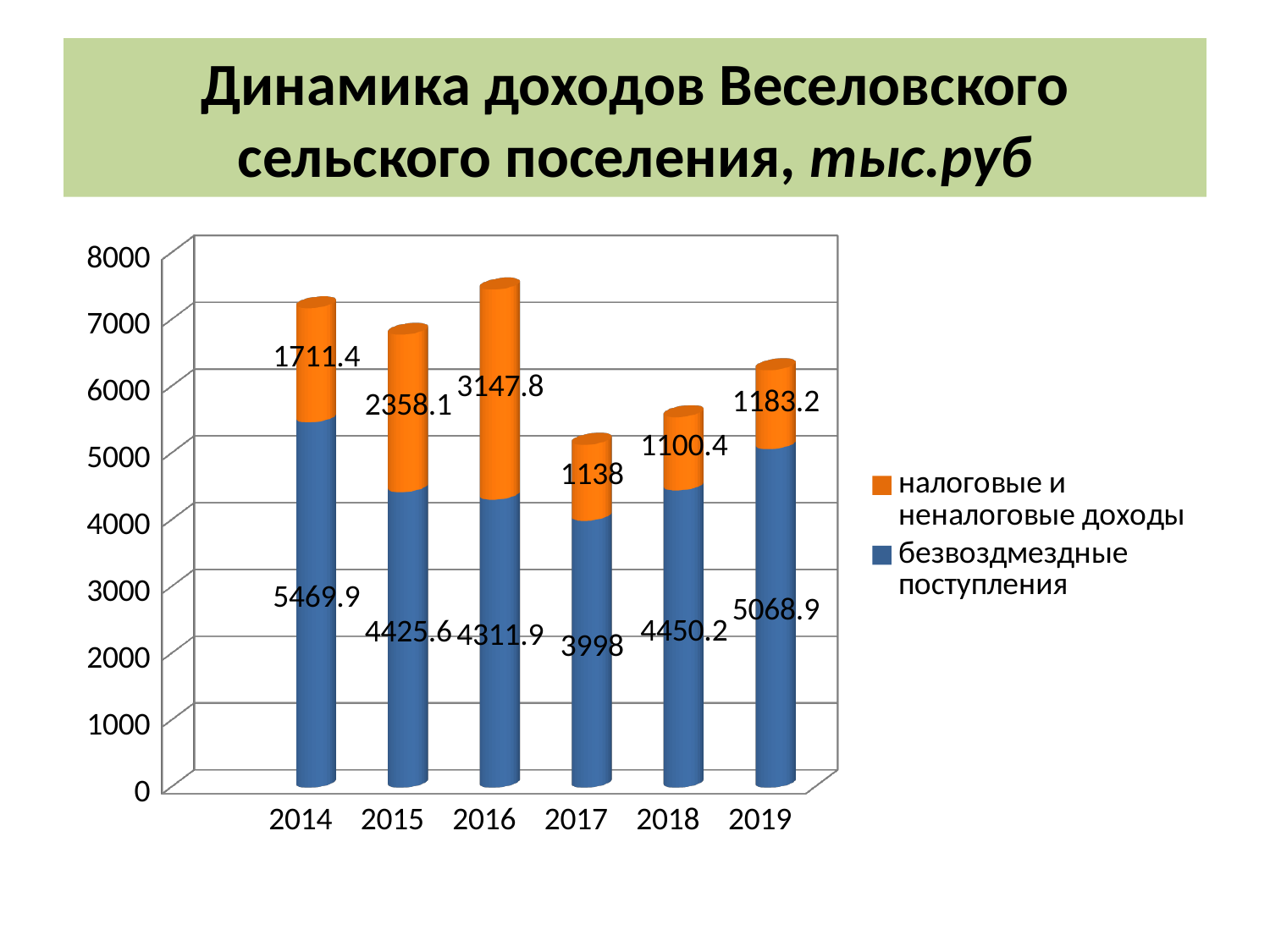
What kind of chart is shown on the slide? Stacked bar chart How many series does the legend list? 2 Which is larger: налоговые и неналоговые доходы in 2015 or in 2017? 2015 In which year is the value of налоговые и неналоговые доходы the highest? 2016 How many years are shown on the x axis? 6 What is the value of налоговые и неналоговые доходы for 2016? 3147.8 In which year is the value of безвозмездные поступления the lowest? 2017 What is the difference between безвозмездные поступления in 2014 and in 2019? 401 What is the total of the stacked bar for 2016? 7459.7 What is the value of налоговые и неналоговые доходы for 2018? 1100.4 What is the value of безвозмездные поступления for 2014? 5469.9 What is the total of the stacked bar for 2017? 5136